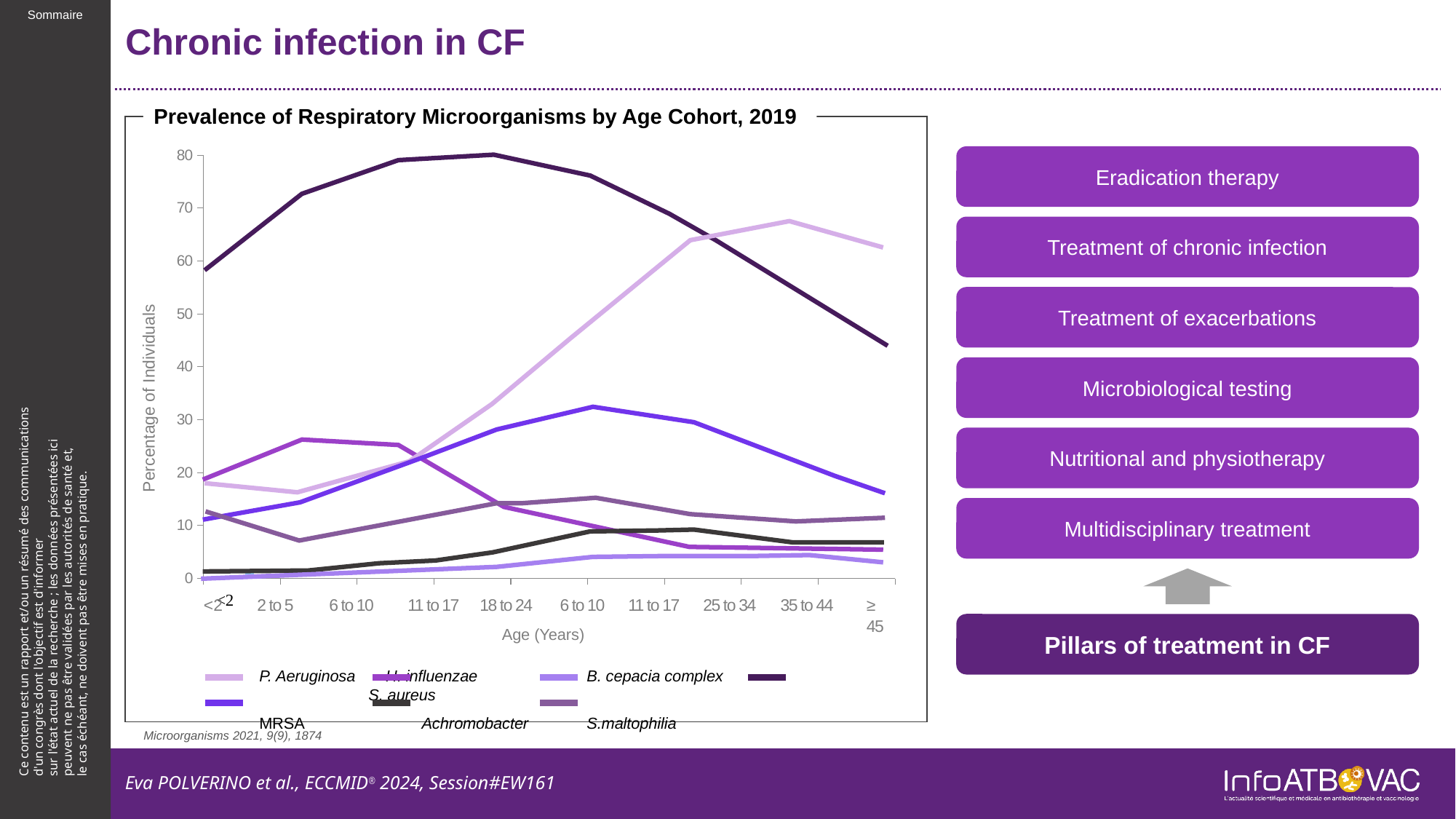
Does the S. aureus line rise or fall from the 18 to 24 cohort to the ≥45 cohort? fall What is the label of the y axis? Percentage of Individuals Is the value for S. aureus in the ≥45 age cohort greater or less than 40? greater Which microorganism has the highest prevalence in the 18 to 24 age cohort? S. aureus Which microorganism has the lowest prevalence in the <2 age cohort? B. cepacia complex In the ≥45 age cohort, which is larger: P. Aeruginosa or S. aureus? P. Aeruginosa How many age cohort categories are shown on the x axis? 10 Is the value for S. aureus in the <2 age cohort greater or less than 60? less How many series does the chart legend list? 7 Is the value for P. Aeruginosa in the 35 to 44 age cohort greater or less than 60? greater What kind of chart is shown on the slide? line chart What is the title of the chart? Prevalence of Respiratory Microorganisms by Age Cohort, 2019